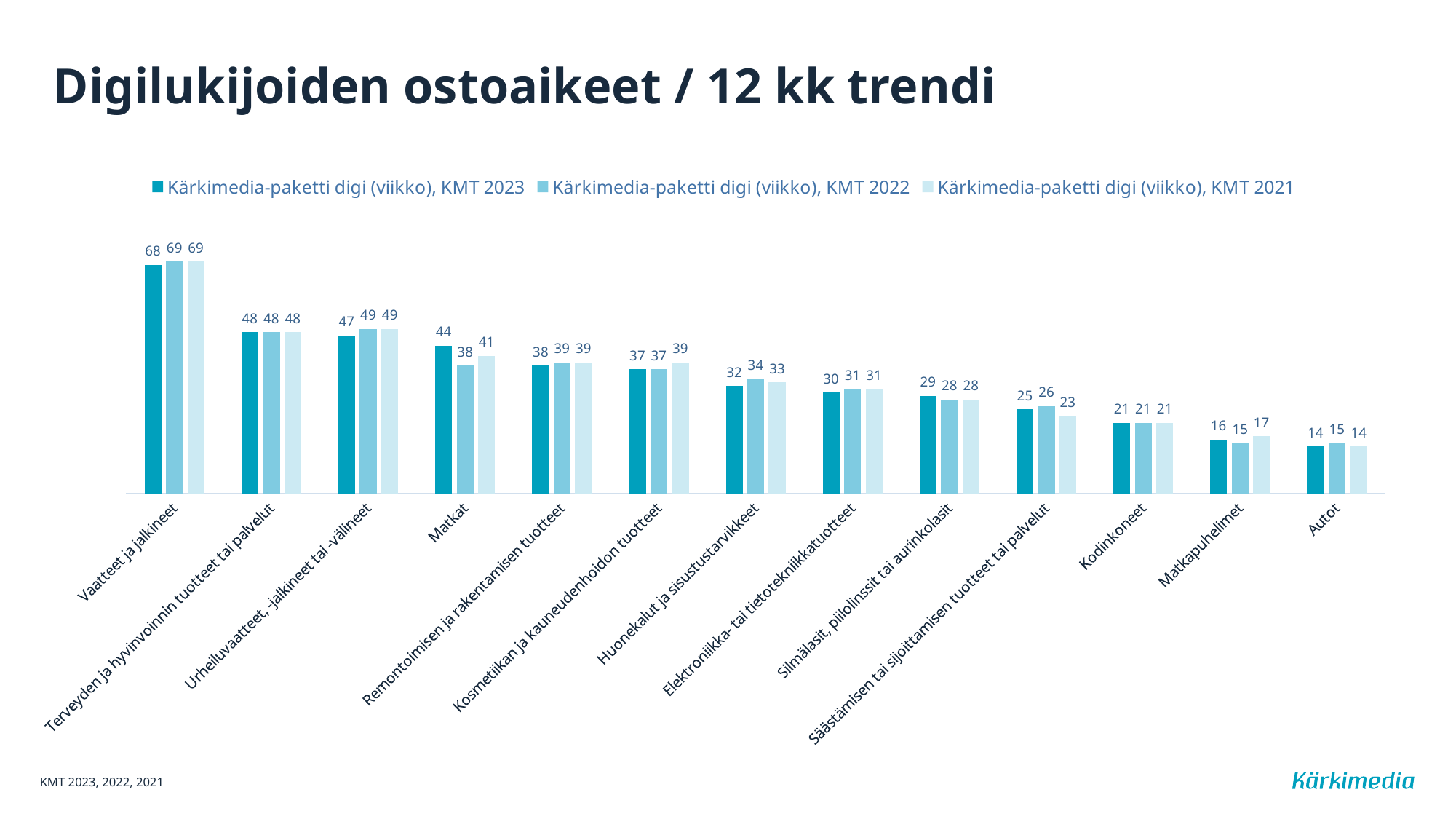
What is the value for Autot in the KMT 2022 series? 15 What is the difference between the KMT 2023 and KMT 2022 values for Matkat? 6 What is the value for Matkat in the Kärkimedia-paketti digi (viikko), KMT 2023 series? 44 What is the value for Kosmetiikan ja kauneudenhoidon tuotteet in the KMT 2021 series? 39 What is the title of the chart on the slide? Digilukijoiden ostoaikeet / 12 kk trendi Which is larger for Säästämisen tai sijoittamisen tuotteet tai palvelut: the KMT 2022 value or the KMT 2021 value? KMT 2022 Do the KMT 2023 values generally rise or fall from left to right along the x axis? Fall Which category has the highest value in the KMT 2023 series? Vaatteet ja jalkineet What kind of chart is shown on the slide? Bar chart Which category has the lowest value in the KMT 2021 series? Autot How many series does the legend list? 3 How many categories are shown on the x axis? 13